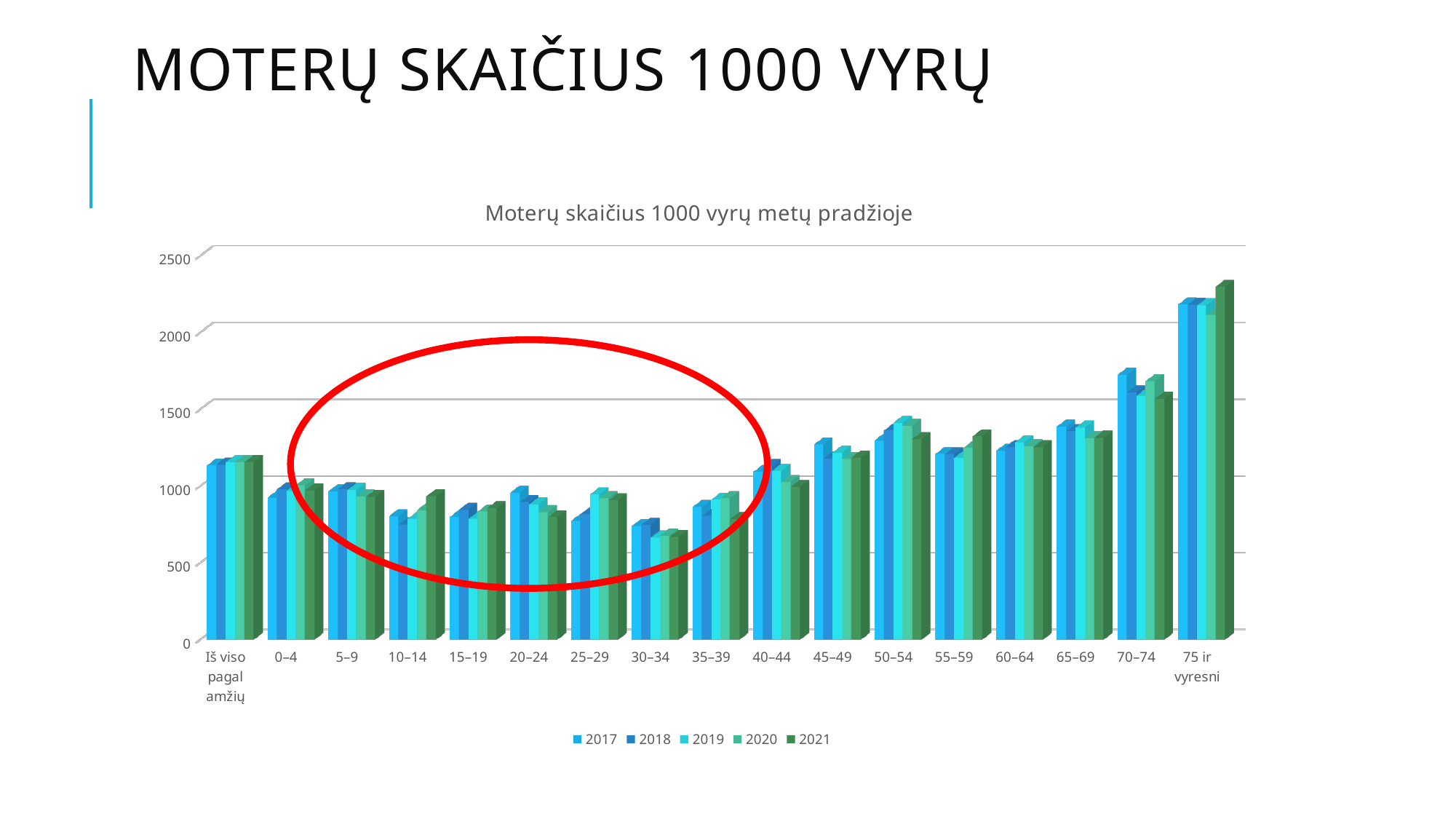
What is the title of the chart? Moterų skaičius 1000 vyrų metų pradžioje Is the 2017 value for 45–49 greater or less than 1000? greater Do the 2021 values generally rise or fall from the 40–44 category to the 75 ir vyresni category? rise Which age category has the lowest values in the chart? 30–34 How many series does the chart legend list? 5 Is the 2017 value for 70–74 greater or less than 1500? greater What kind of chart is shown on the slide? bar chart Which age category has the highest values in the chart? 75 ir vyresni Is the 2021 value for 30–34 greater or less than 1000? less For the 70–74 category, which is larger: the 2017 value or the 2021 value? 2017 How many age categories are shown on the x axis of the chart? 17